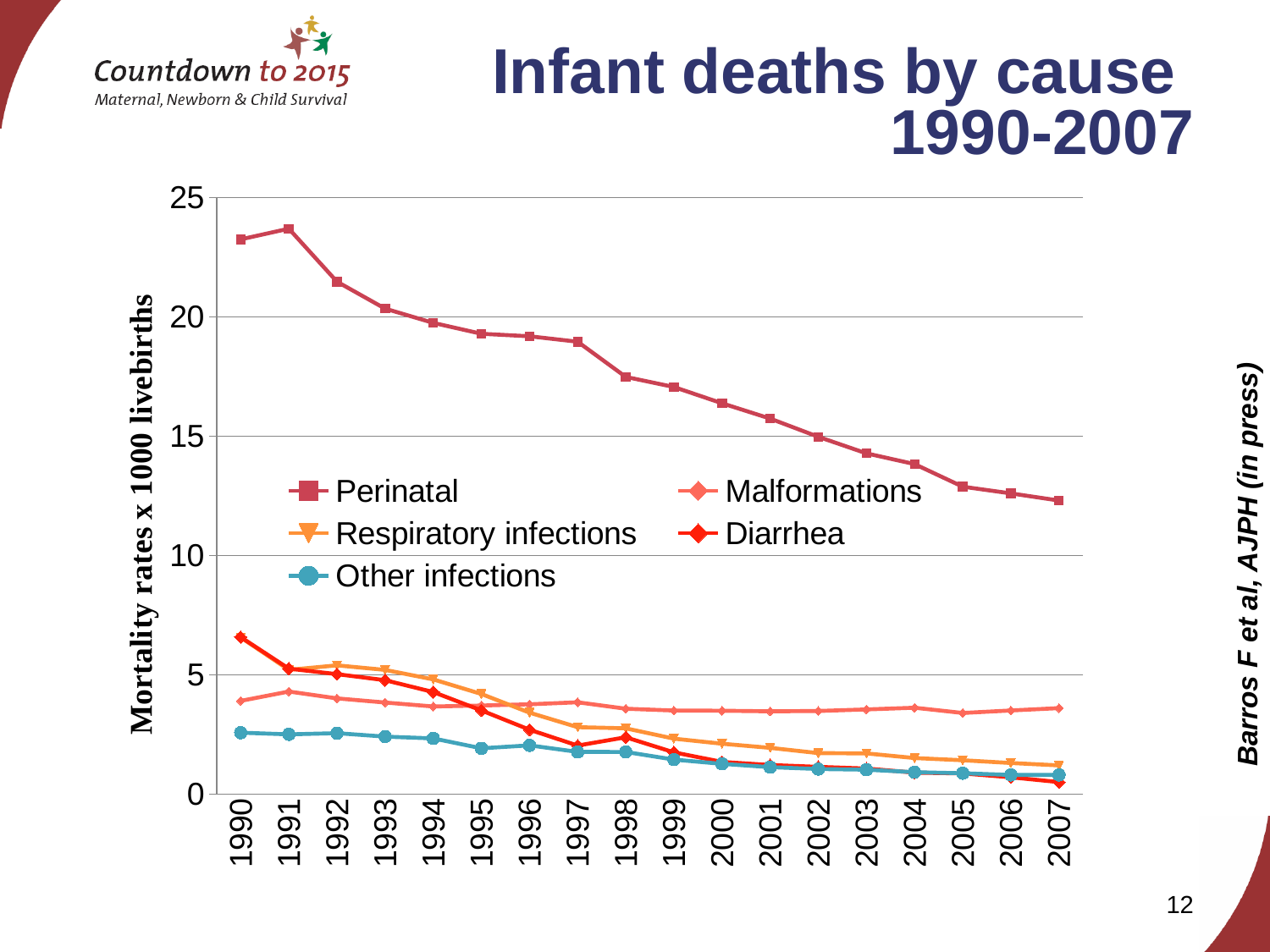
What kind of chart is shown on the slide? line chart In 2007, which is larger: the Malformations value or the Diarrhea value? Malformations How many series does the legend list? 5 Is the Perinatal value for 1990 greater or less than 20? greater Is the Perinatal value for 2007 greater or less than 15? less Which cause has the lowest mortality rate in 2007? Diarrhea Is the Other infections value for 1990 greater or less than 5? less Do the Perinatal mortality rates rise or fall from 1990 to 2007? fall What is the label on the y axis? Mortality rates x 1000 livebirths How many years are plotted along the x axis? 18 Which cause has the highest mortality rate in 1990? Perinatal